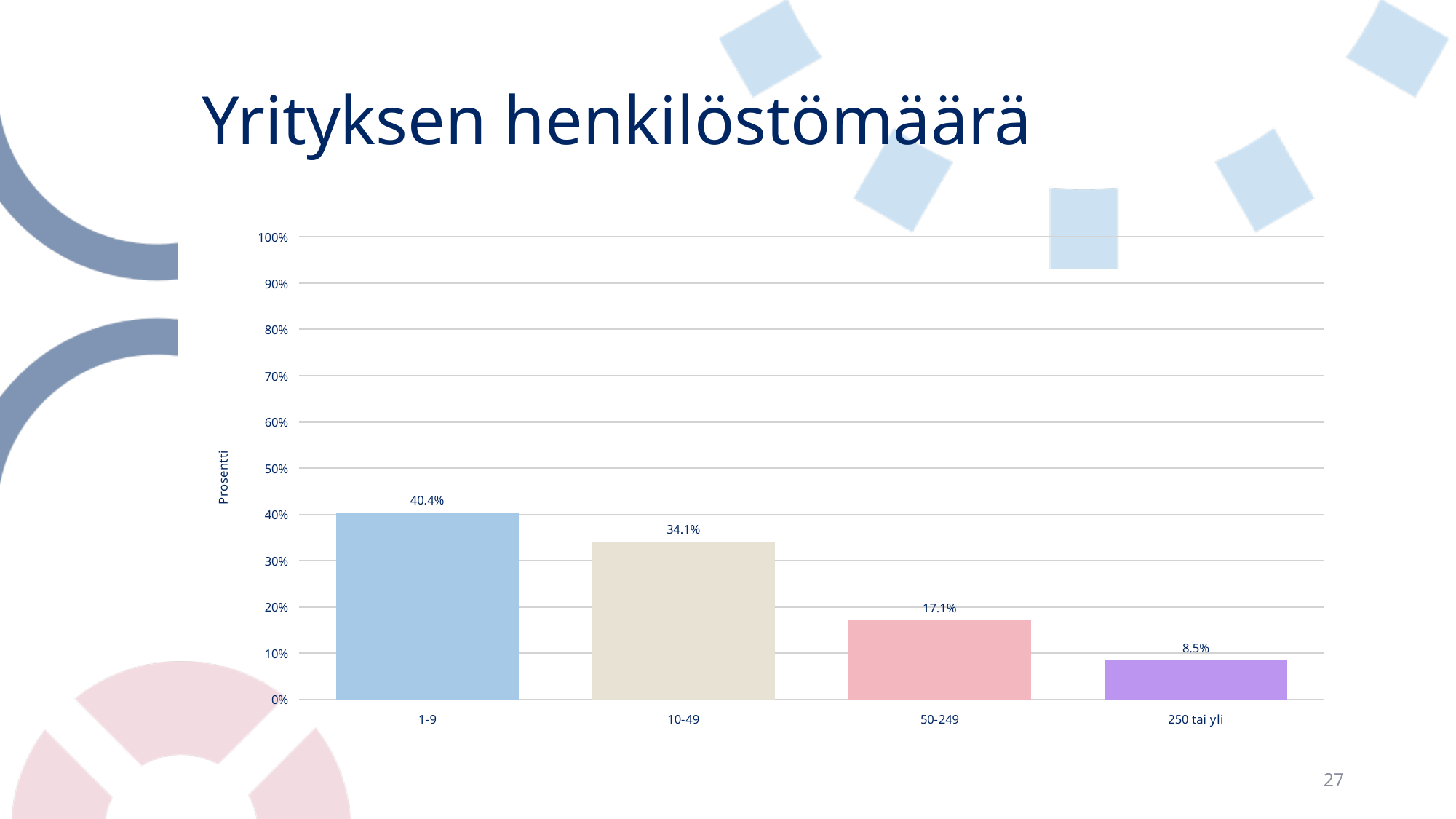
What is the label of the y axis? Prosentti What is the value for the 50-249 category? 17.1% What is the value for the 10-49 category? 34.1% Which is larger, the value for 50-249 or the value for 250 tai yli? 50-249 Which category has the lowest value? 250 tai yli What is the value for the 1-9 category? 40.4% Which category has the highest value? 1-9 How many categories are shown on the x axis? 4 Is the value for 10-49 greater or less than 30%? greater What is the value for the 250 tai yli category? 8.5% What is the difference between the values for 1-9 and 10-49? 6.3% What kind of chart is shown on the slide? bar chart